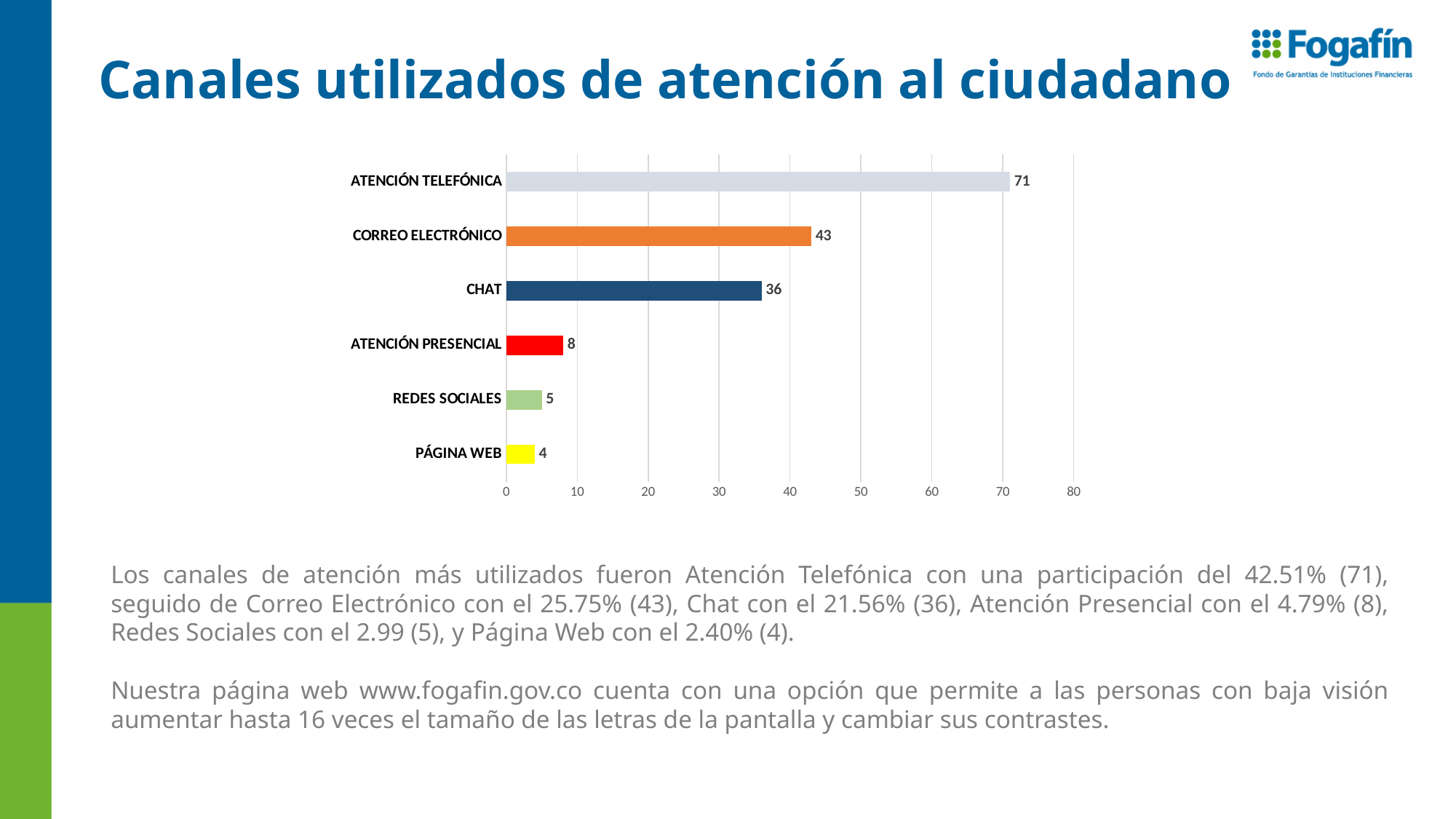
What is the value for ATENCIÓN TELEFÓNICA? 71 What is the value for CHAT? 36 How many channels are shown in the chart? 6 What is the value for CORREO ELECTRÓNICO? 43 What kind of chart is shown on the slide? bar chart What is the difference between the values for ATENCIÓN TELEFÓNICA and CORREO ELECTRÓNICO? 28 Which channel has the highest value? ATENCIÓN TELEFÓNICA What is the difference between the values for ATENCIÓN PRESENCIAL and REDES SOCIALES? 3 Is the value for CORREO ELECTRÓNICO greater or less than 40? greater What is the value for PÁGINA WEB? 4 Which is larger, the value for CHAT or the value for ATENCIÓN PRESENCIAL? CHAT Which channel has the lowest value? PÁGINA WEB